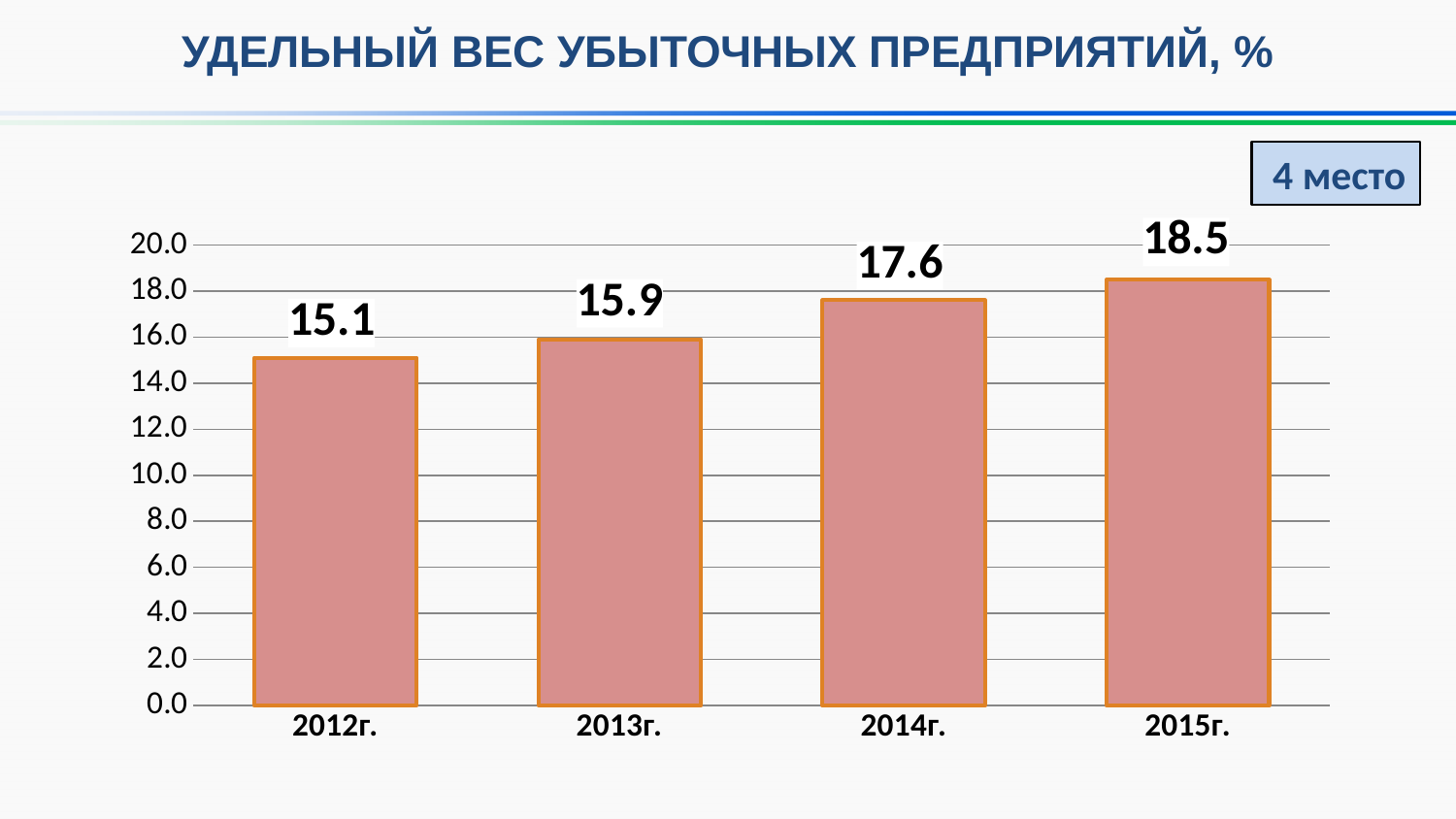
Which year has the highest value? 2015г. What is the value for 2012г.? 15.1 What is the value for 2014г.? 17.6 What is the value for 2015г.? 18.5 What is the difference between the values for 2014г. and 2013г.? 1.7 How many years are shown on the chart? 4 Is the value for 2013г. greater or less than 16.0? less Which year has the lowest value? 2012г. Which is larger, the value for 2013г. or the value for 2014г.? 2014г. What kind of chart is shown on the slide? bar chart What is the difference between the values for 2015г. and 2012г.? 3.4 Do the values rise or fall from 2012г. to 2015г.? rise